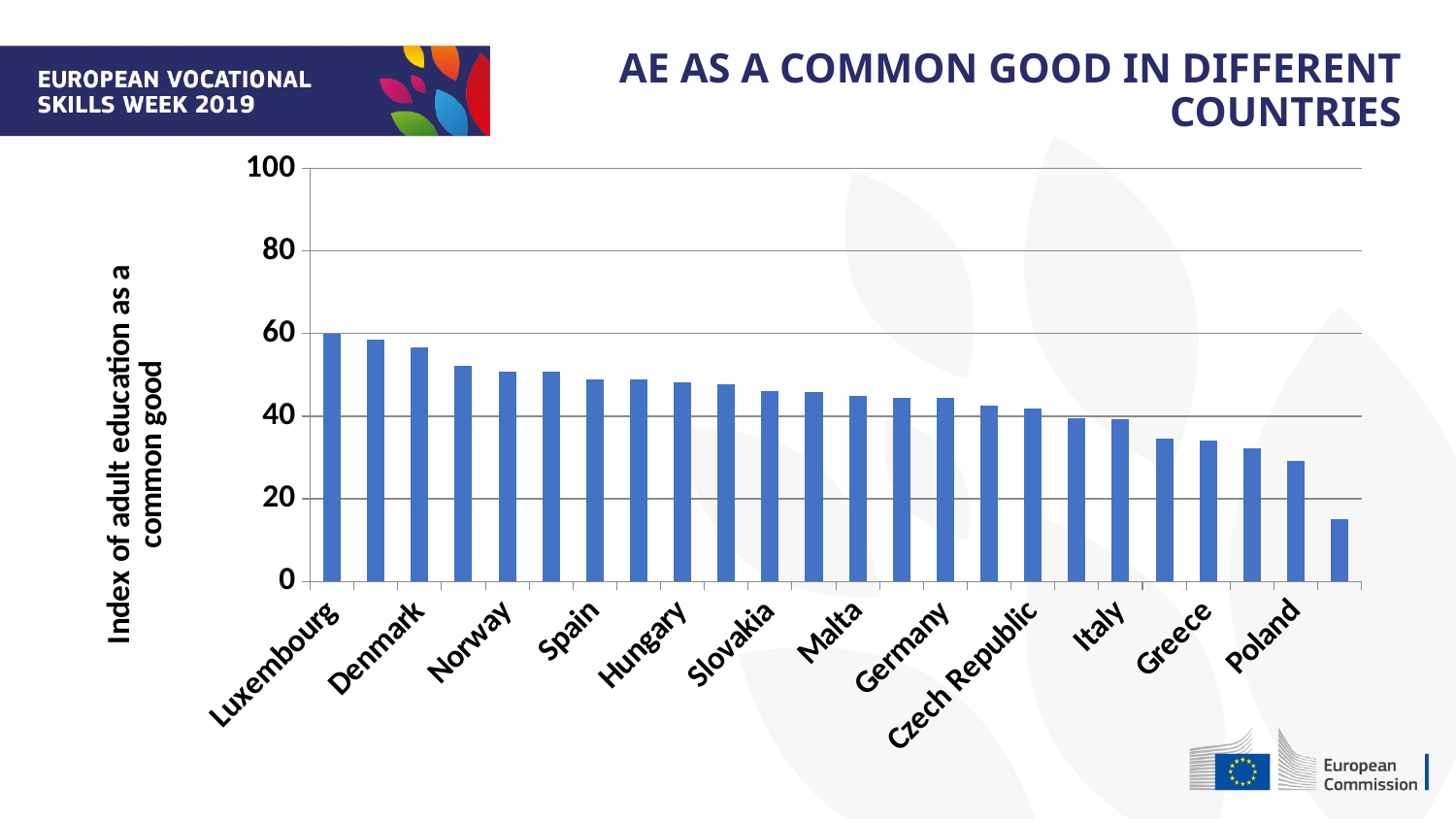
Is the value for Hungary greater or less than 60? less Is the value for Greece greater or less than 40? less Do the bar values rise or fall from left to right along the x axis? fall Is the value for Poland greater or less than 40? less Which has a higher index value, Denmark or Greece? Denmark What kind of chart is shown on the slide? bar chart Which country has the highest index of adult education as a common good? Luxembourg How many country names are labelled on the x axis? 12 Which has a higher index value, Poland or Luxembourg? Luxembourg What is the title of the vertical axis? Index of adult education as a common good